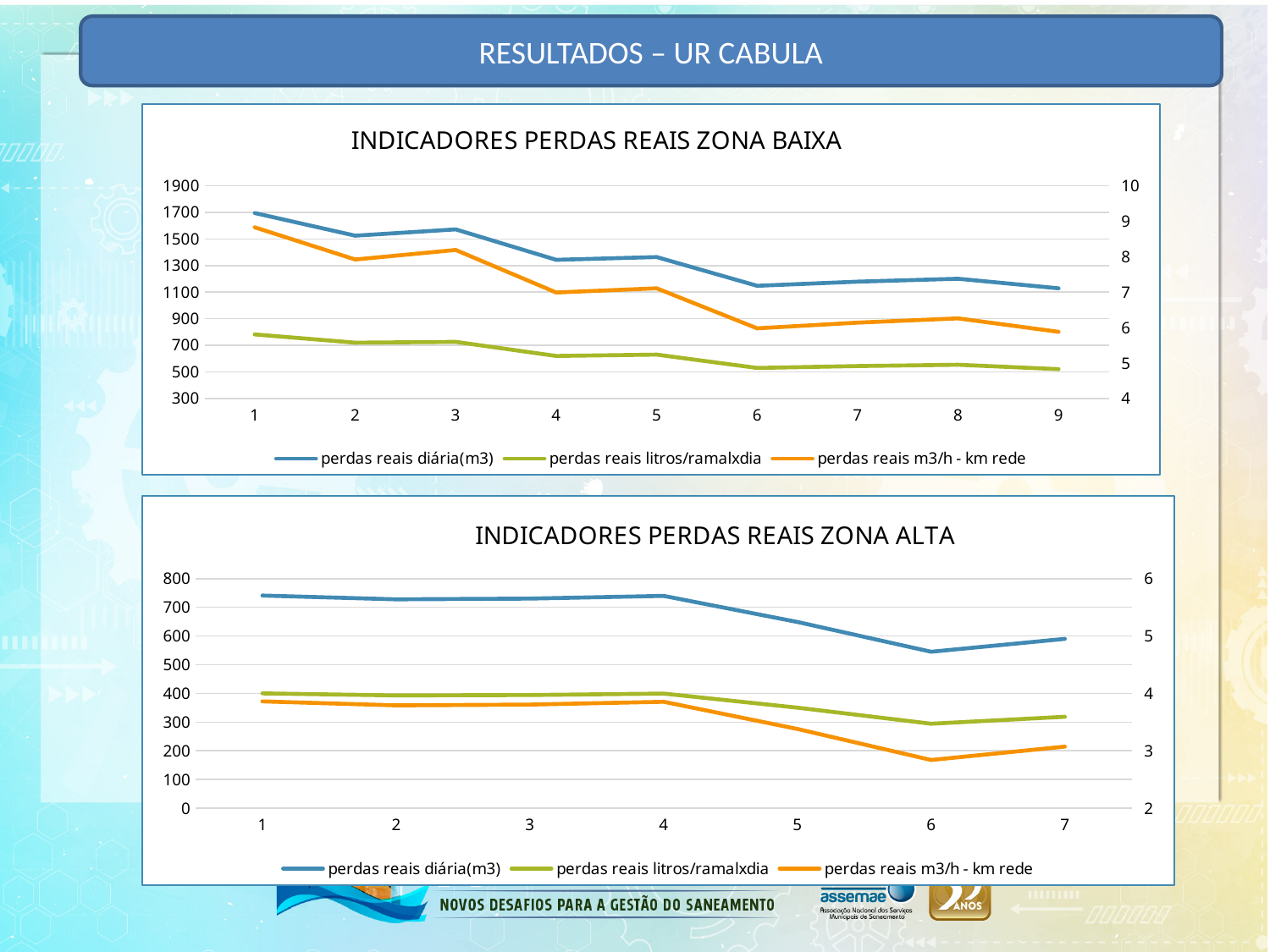
How many points are plotted along the x axis of the INDICADORES PERDAS REAIS ZONA BAIXA chart? 9 How many points are plotted along the x axis of the INDICADORES PERDAS REAIS ZONA ALTA chart? 7 In the INDICADORES PERDAS REAIS ZONA BAIXA chart, at which x-axis point is perdas reais diária(m3) highest? 1 In the INDICADORES PERDAS REAIS ZONA BAIXA chart, is the value of perdas reais diária(m3) at point 1 greater or less than 1500? greater In the INDICADORES PERDAS REAIS ZONA BAIXA chart, does the perdas reais diária(m3) series rise or fall from point 1 to point 9? fall What kind of chart is the INDICADORES PERDAS REAIS ZONA BAIXA chart? line chart What is the title of the lower chart on the slide? INDICADORES PERDAS REAIS ZONA ALTA How many series does the legend of the INDICADORES PERDAS REAIS ZONA BAIXA chart list? 3 In the INDICADORES PERDAS REAIS ZONA ALTA chart, is the value of perdas reais diária(m3) at point 6 greater or less than 600? less In the INDICADORES PERDAS REAIS ZONA ALTA chart, which series is drawn in orange? perdas reais m3/h - km rede In the INDICADORES PERDAS REAIS ZONA ALTA chart, at which x-axis point is perdas reais diária(m3) lowest? 6 In the INDICADORES PERDAS REAIS ZONA BAIXA chart, is the value of perdas reais litros/ramalxdia at point 1 greater or less than 700? greater